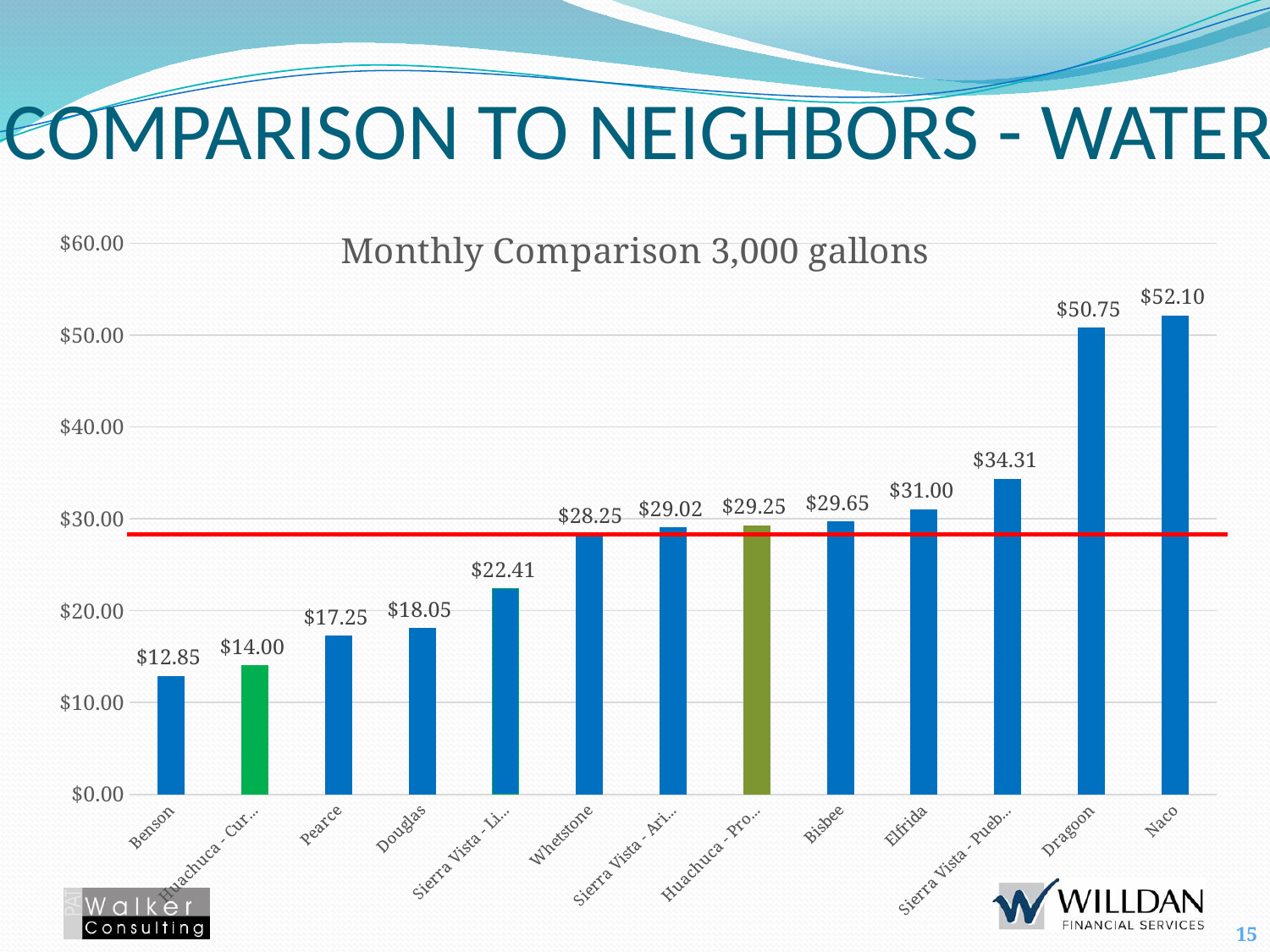
Which category has the highest value? Naco What is the difference between the values for Naco and Dragoon? $1.35 Is the value for Dragoon greater or less than $50.00? greater What is the value for Elfrida? $31.00 What is the difference between the values for Douglas and Pearce? $0.80 How many categories are shown on the x axis? 13 What is the value for Naco? $52.10 Which is larger, the value for Bisbee or the value for Whetstone? Bisbee What is the value for Whetstone? $28.25 What is the title of the chart? Monthly Comparison 3,000 gallons Which category has the lowest value? Benson What is the value for Benson? $12.85